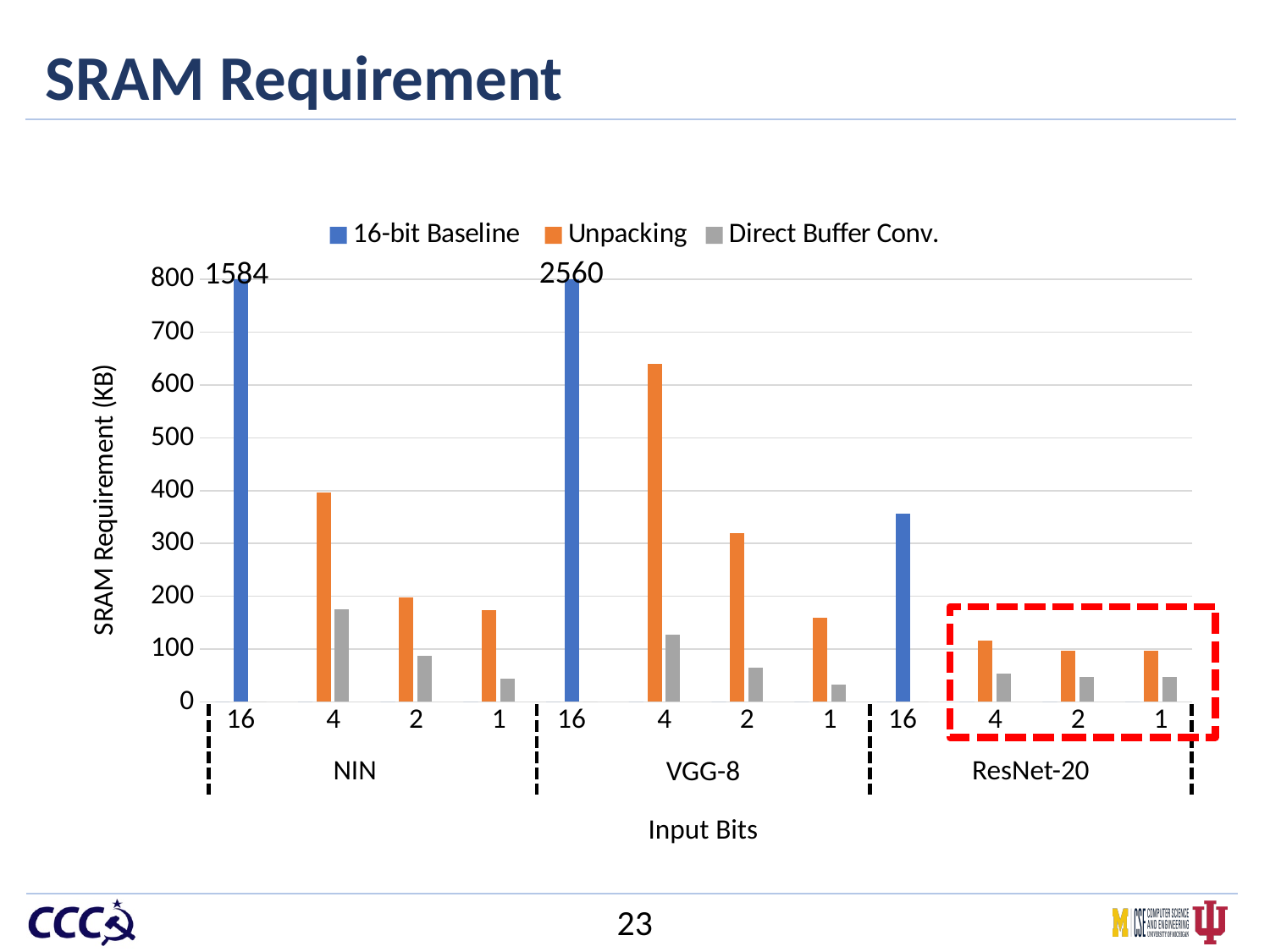
How many network groups are shown along the x axis? 3 What is the title of the y axis? SRAM Requirement (KB) Which network group is highlighted with a red dashed box? ResNet-20 Is the 16-bit Baseline value for ResNet-20 greater or less than 300? greater Within the NIN group, do the Unpacking bars rise or fall as input bits go from 4 to 1? fall Which has the larger 16-bit Baseline SRAM requirement, NIN or VGG-8? VGG-8 What kind of chart is shown on the slide? bar chart How many series does the legend list? 3 What is the 16-bit Baseline SRAM requirement for NIN? 1584 What is the 16-bit Baseline SRAM requirement for VGG-8? 2560 Is the Unpacking value for VGG-8 at 4 input bits greater or less than 600? greater Is the Direct Buffer Conv. value for NIN at 4 input bits greater or less than 200? less